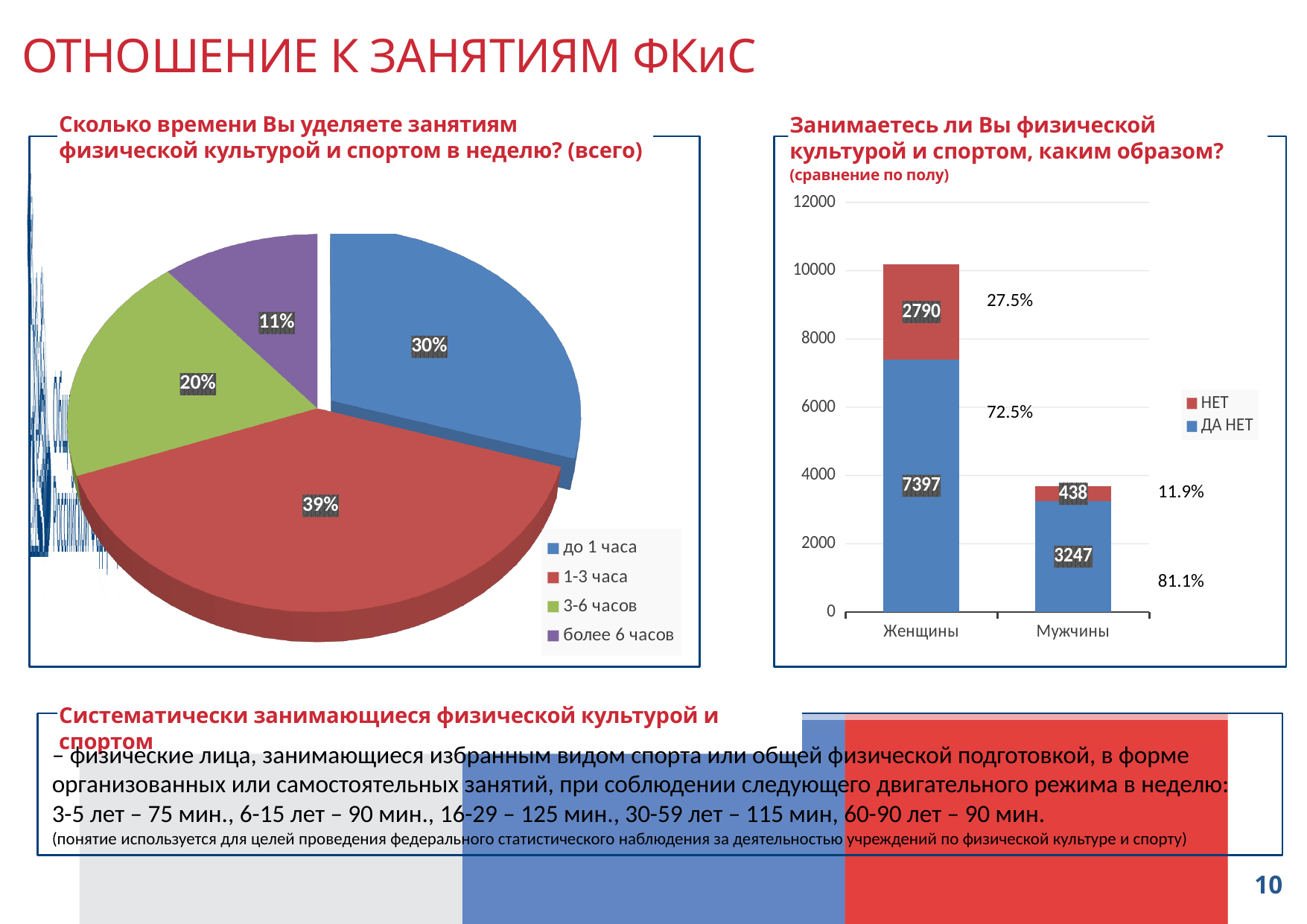
In the bar chart on the right, what is the total of the stacked bar for 'Женщины'? 10187 In the pie chart on the left, what is the difference in percentage points between the 'до 1 часа' and '3-6 часов' slices? 10 What kind of chart is shown on the right side of the slide? Stacked bar chart In the bar chart on the right, what is the value of the blue segment for 'Женщины'? 7397 In the pie chart on the left, which category has the largest slice? 1-3 часа In the pie chart on the left, what share is labelled for the '1-3 часа' slice? 39% In the pie chart on the left, what share is labelled for the 'более 6 часов' slice? 11% In the bar chart on the right, which group has the taller stacked bar, 'Женщины' or 'Мужчины'? Женщины In the pie chart on the left, which category has the smallest slice? более 6 часов In the pie chart on the left, how many categories does the legend list? 4 In the bar chart on the right, what is the value of the red segment for 'Мужчины'? 438 In the bar chart on the right, is the total bar for 'Мужчины' greater or less than 4000? less